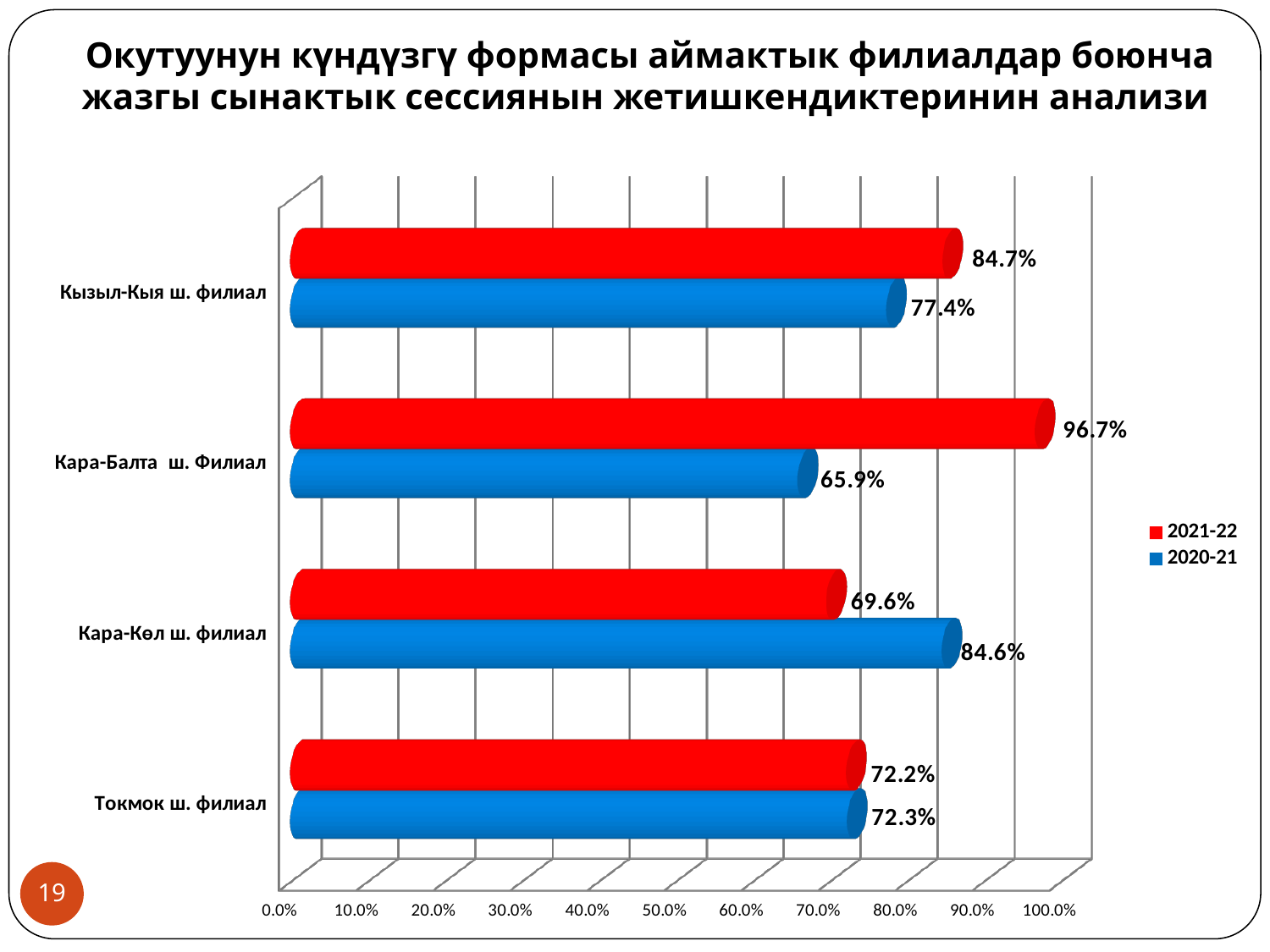
How many series does the legend list? 2 For Кара-Көл ш. филиал, which is larger: the 2021-22 value or the 2020-21 value? 2020-21 How many branches are shown on the chart? 4 What is the difference between the 2021-22 and 2020-21 values for Кара-Балта ш. Филиал? 30.8% What is the 2021-22 value for Кара-Балта ш. Филиал? 96.7% Which colour represents the 2020-21 series in the legend? blue Which branch has the lowest 2020-21 value? Кара-Балта ш. Филиал What is the 2020-21 value for Кызыл-Кыя ш. филиал? 77.4% What is the 2020-21 value for Кара-Көл ш. филиал? 84.6% Which branch has the highest 2021-22 value? Кара-Балта ш. Филиал What kind of chart is shown on the slide? bar chart Is the 2021-22 value for Кара-Көл ш. филиал greater or less than 80.0%? less